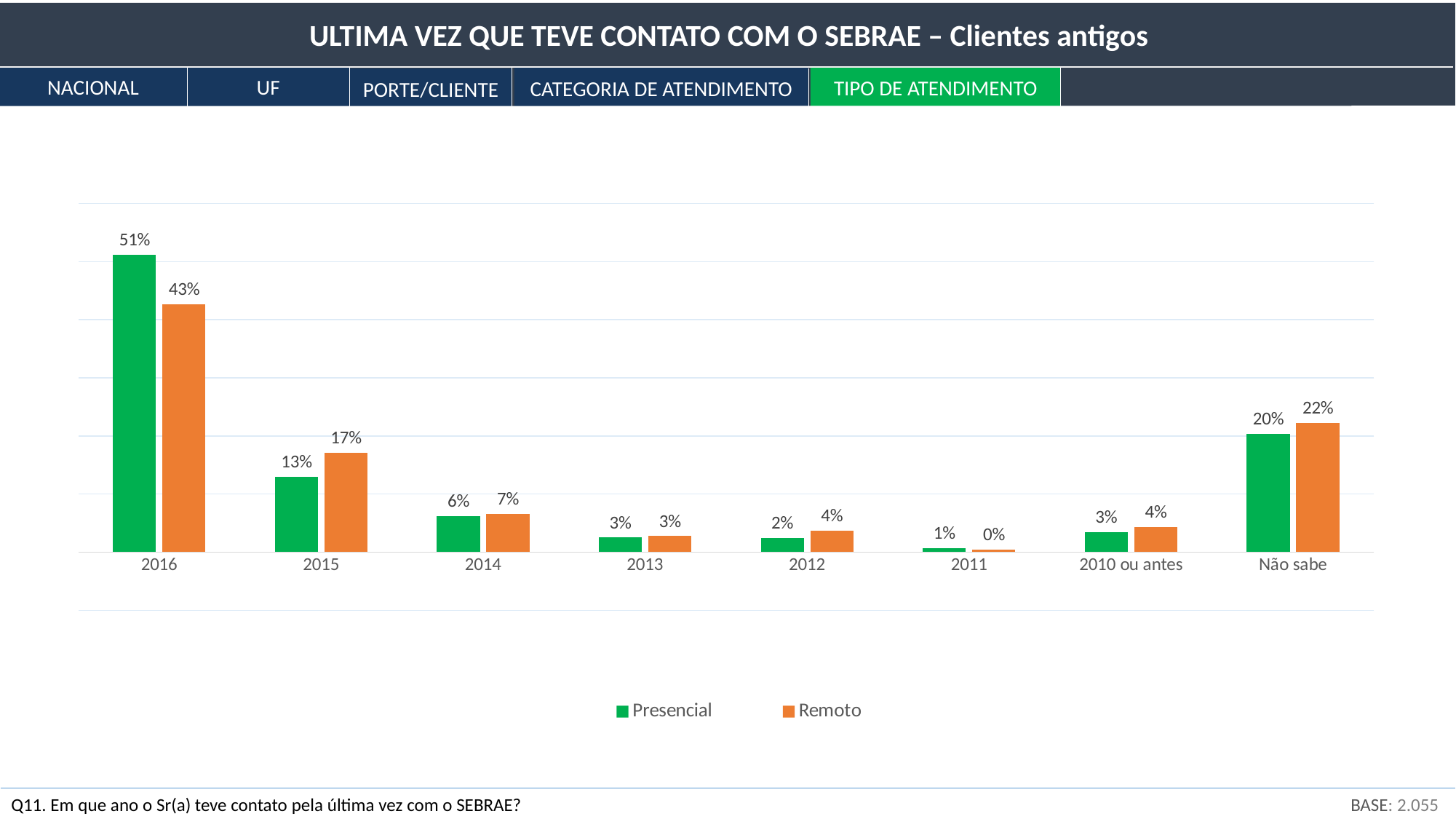
Which category has the lowest Remoto value? 2011 What is the difference between the Presencial and Remoto values for 2016? 8% How many series does the legend list? 2 What is the Presencial value for 2010 ou antes? 3% Which colour represents the Remoto series? Orange What is the Remoto value for 2015? 17% What is the Remoto value for Não sabe? 22% Which is larger for 2015, Presencial or Remoto? Remoto What kind of chart is shown on the slide? Bar chart What is the Presencial value for 2016? 51% Which category has the highest Presencial value? 2016 How many categories are shown on the x axis? 8